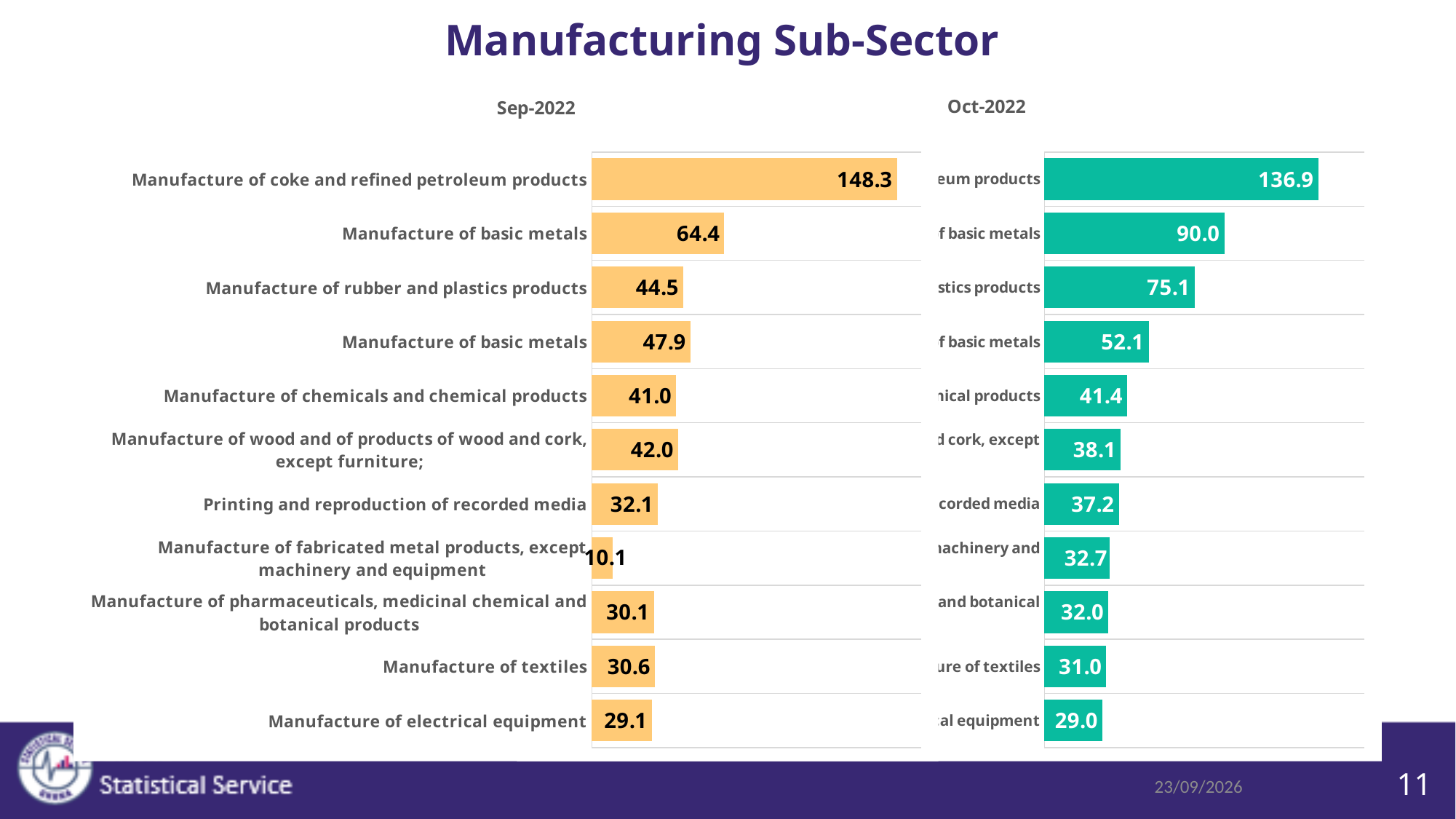
In the Sep-2022 chart, which is larger: Manufacture of rubber and plastics products or Manufacture of chemicals and chemical products? Manufacture of rubber and plastics products In the Sep-2022 chart, what is the value for Manufacture of textiles? 30.6 In the Oct-2022 chart, what is the value shown on the top bar? 136.9 What kind of chart is the Sep-2022 chart? Bar chart In the Sep-2022 chart, what is the value for Printing and reproduction of recorded media? 32.1 In the Sep-2022 chart, what is the value for Manufacture of coke and refined petroleum products? 148.3 In the Sep-2022 chart, which category has the highest value? Manufacture of coke and refined petroleum products What is the difference between the top bar of the Sep-2022 chart and the top bar of the Oct-2022 chart? 11.4 In the Sep-2022 chart, which category has the lowest value? Manufacture of fabricated metal products, except machinery and equipment In the Sep-2022 chart, what is the difference between the value for Manufacture of wood and of products of wood and cork, except furniture and the value for Manufacture of chemicals and chemical products? 1.0 How many categories are plotted in the Sep-2022 chart? 11 In the Oct-2022 chart, what is the value shown on the bar for textiles? 31.0